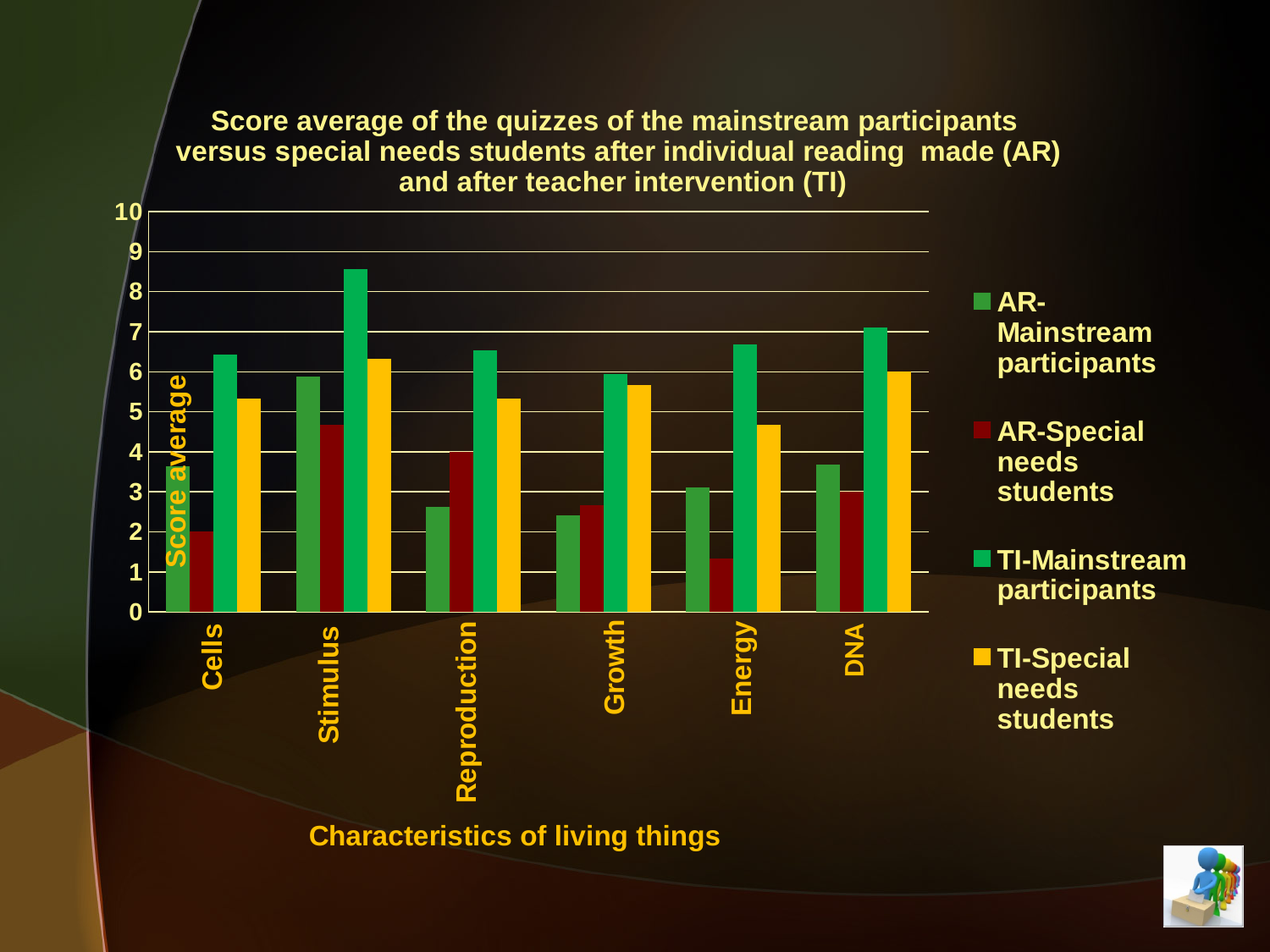
Is the value for TI-Mainstream participants in Stimulus greater or less than 8? greater What kind of chart is shown on the slide? bar chart Is the value for AR-Special needs students in Cells greater or less than 3? less What is the title of the y axis of the chart? Score average Is the value for AR-Mainstream participants in Stimulus greater or less than 5? greater What is the title of the x axis of the chart? Characteristics of living things For the TI-Mainstream participants series, which category has the highest score average? Stimulus How many categories are shown on the x axis of the chart? 6 For the AR-Special needs students series, which category has the lowest score average? Energy How many series does the legend list? 4 In the Cells category, which is larger: TI-Mainstream participants or TI-Special needs students? TI-Mainstream participants In the Reproduction category, which is larger: AR-Mainstream participants or AR-Special needs students? AR-Special needs students